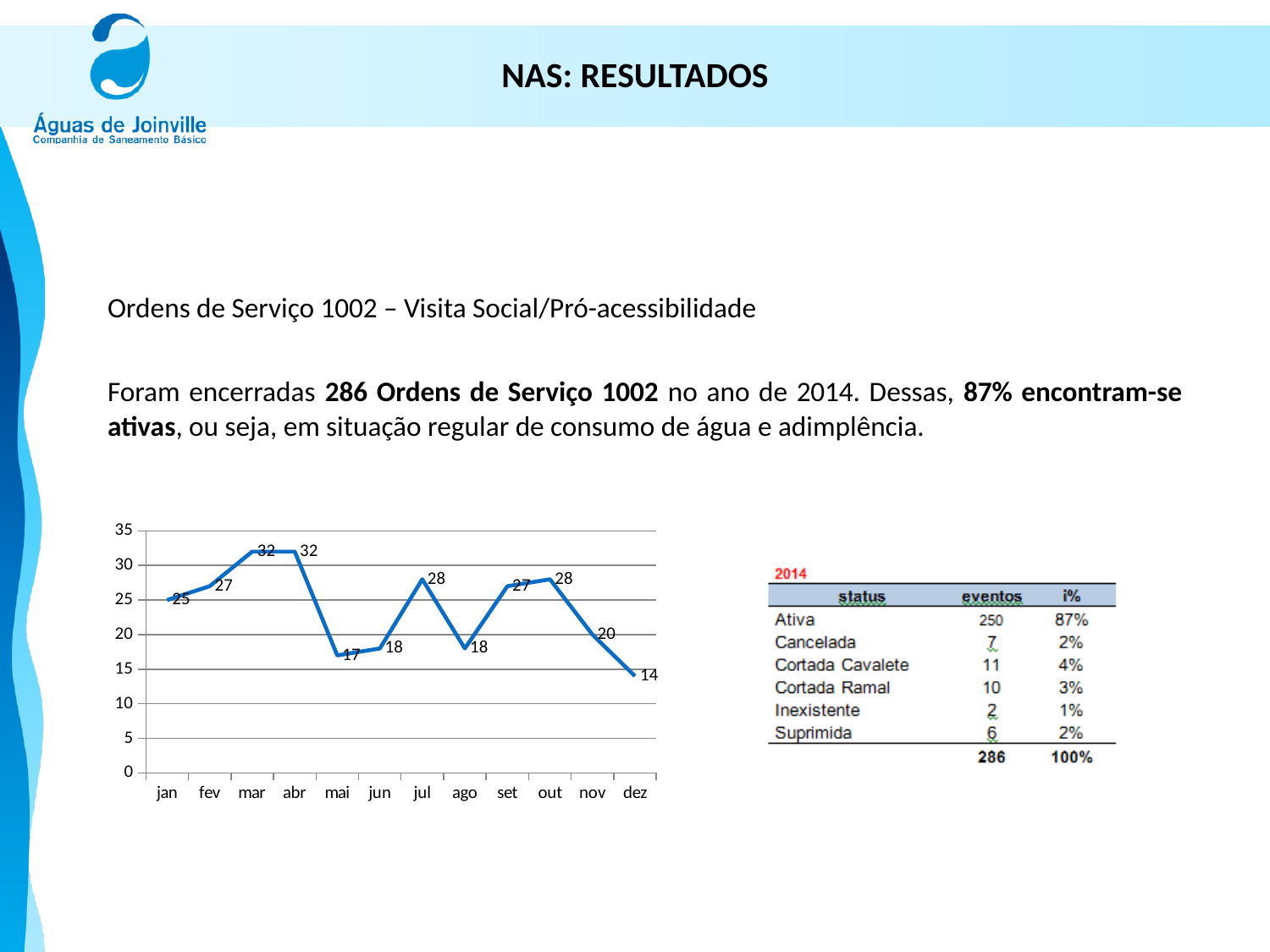
What is the value for dez? 14 What is the value for jul? 28 Which is larger, the value for nov or the value for dez? nov Do the values rise or fall from out to dez? fall How many months are plotted on the x axis? 12 What is the value for jan? 25 Which month has the lowest value? dez What kind of chart is shown on the slide? line chart What is the difference between the values for abr and mai? 15 What is the highest value plotted on the chart? 32 What is the value for mai? 17 What is the difference between the values for jan and fev? 2